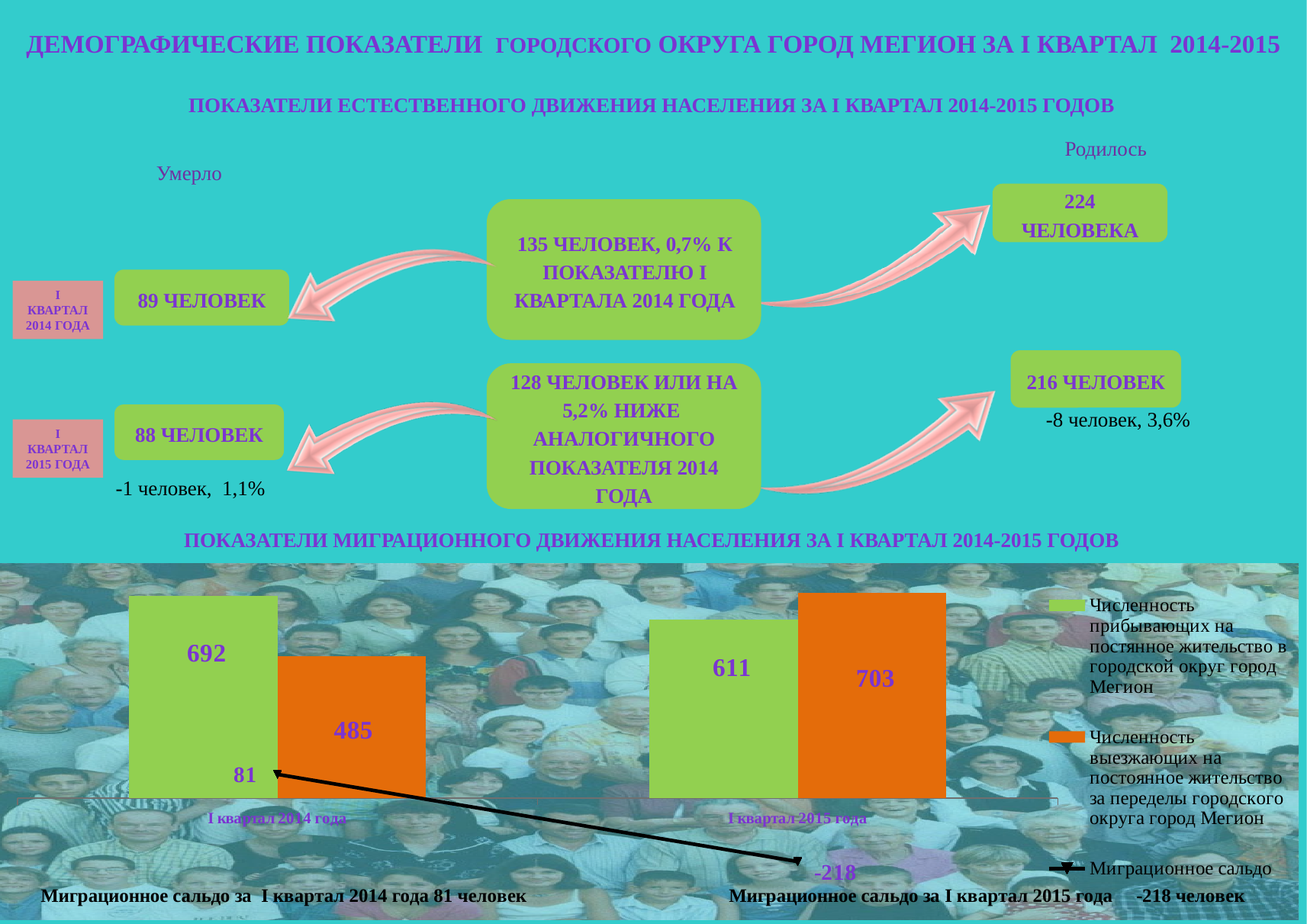
In the migration chart, which category has the highest number of arrivals? I квартал 2014 года In the migration chart, what is the migration balance (миграционное сальдо) for I квартал 2015 года? -218 In the migration chart, what is the number of people arriving for permanent residence in I квартал 2014 года? 692 In the migration chart, what is the number of people leaving in I квартал 2014 года? 485 In the migration chart, what is the difference between arrivals and departures in I квартал 2014 года? 207 In the migration chart, does the migration balance rise or fall from I квартал 2014 года to I квартал 2015 года? fall What kind of chart is shown in the migration section at the bottom of the slide? combination bar and line chart In the migration chart, what is the number of people leaving for permanent residence in I квартал 2015 года? 703 In the migration chart, what is the number of people arriving in I квартал 2015 года? 611 In the migration chart, which is larger in I квартал 2015 года: arrivals or departures? departures (703) How many categories (quarters) are shown on the x axis of the migration chart? 2 How many entries does the legend of the migration chart list? 3